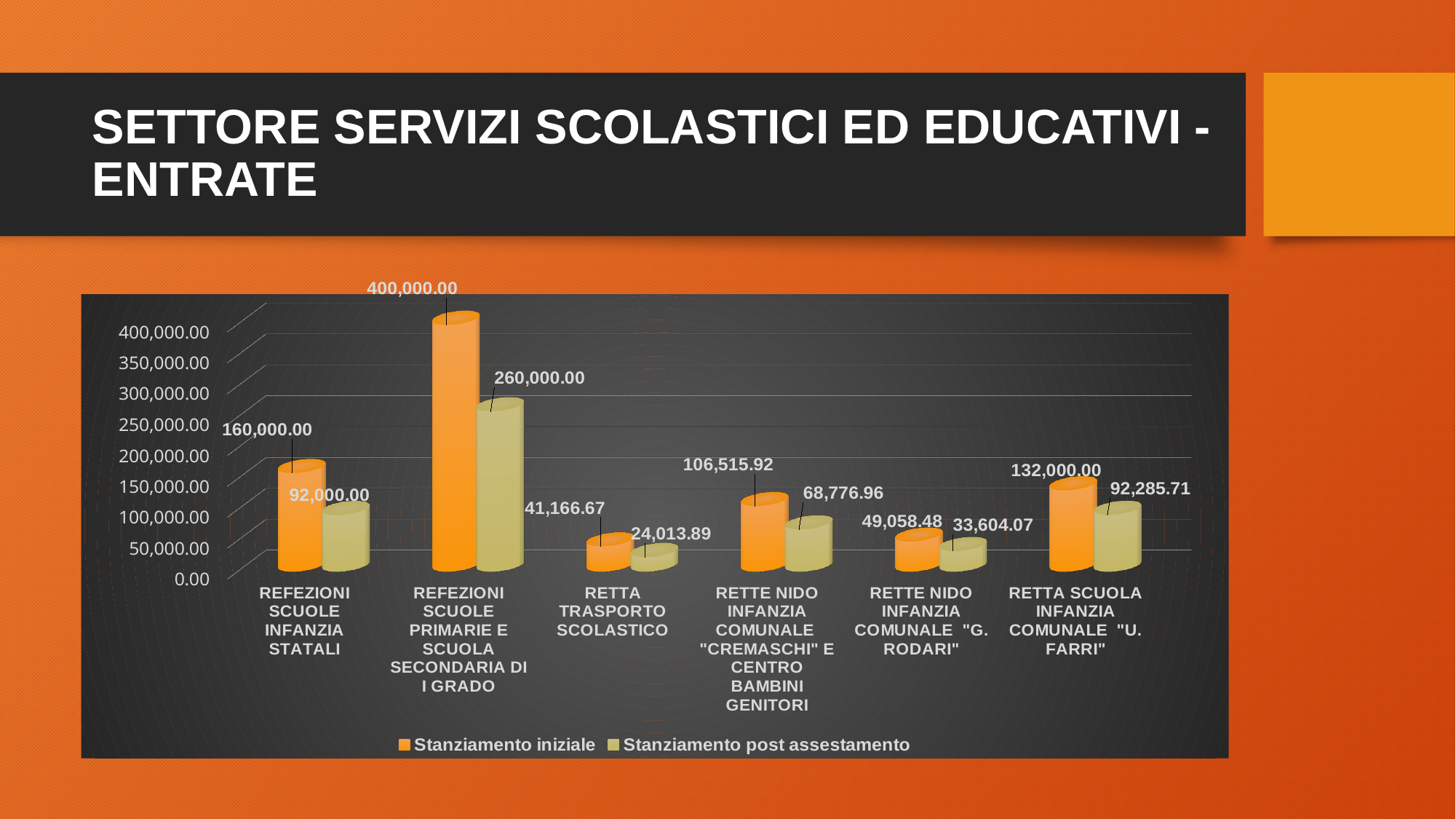
What is the Stanziamento post assestamento value for RETTE NIDO INFANZIA COMUNALE "G. RODARI"? 33,604.07 How many categories are shown on the x axis of the chart? 6 Which is larger: the Stanziamento iniziale for RETTA SCUOLA INFANZIA COMUNALE "U. FARRI" or the Stanziamento iniziale for RETTE NIDO INFANZIA COMUNALE "CREMASCHI" E CENTRO BAMBINI GENITORI? RETTA SCUOLA INFANZIA COMUNALE "U. FARRI" Which category has the lowest Stanziamento post assestamento value? RETTA TRASPORTO SCOLASTICO What is the difference between the Stanziamento iniziale and Stanziamento post assestamento values for REFEZIONI SCUOLE PRIMARIE E SCUOLA SECONDARIA DI I GRADO? 140,000.00 What kind of chart is shown on the slide? Bar chart How many series does the chart legend list? 2 What is the Stanziamento iniziale value for RETTE NIDO INFANZIA COMUNALE "CREMASCHI" E CENTRO BAMBINI GENITORI? 106,515.92 What is the Stanziamento iniziale value for RETTA TRASPORTO SCOLASTICO? 41,166.67 Which category has the highest Stanziamento iniziale value? REFEZIONI SCUOLE PRIMARIE E SCUOLA SECONDARIA DI I GRADO What is the Stanziamento post assestamento value for RETTA SCUOLA INFANZIA COMUNALE "U. FARRI"? 92,285.71 What is the difference between the Stanziamento iniziale and Stanziamento post assestamento values for REFEZIONI SCUOLE INFANZIA STATALI? 68,000.00